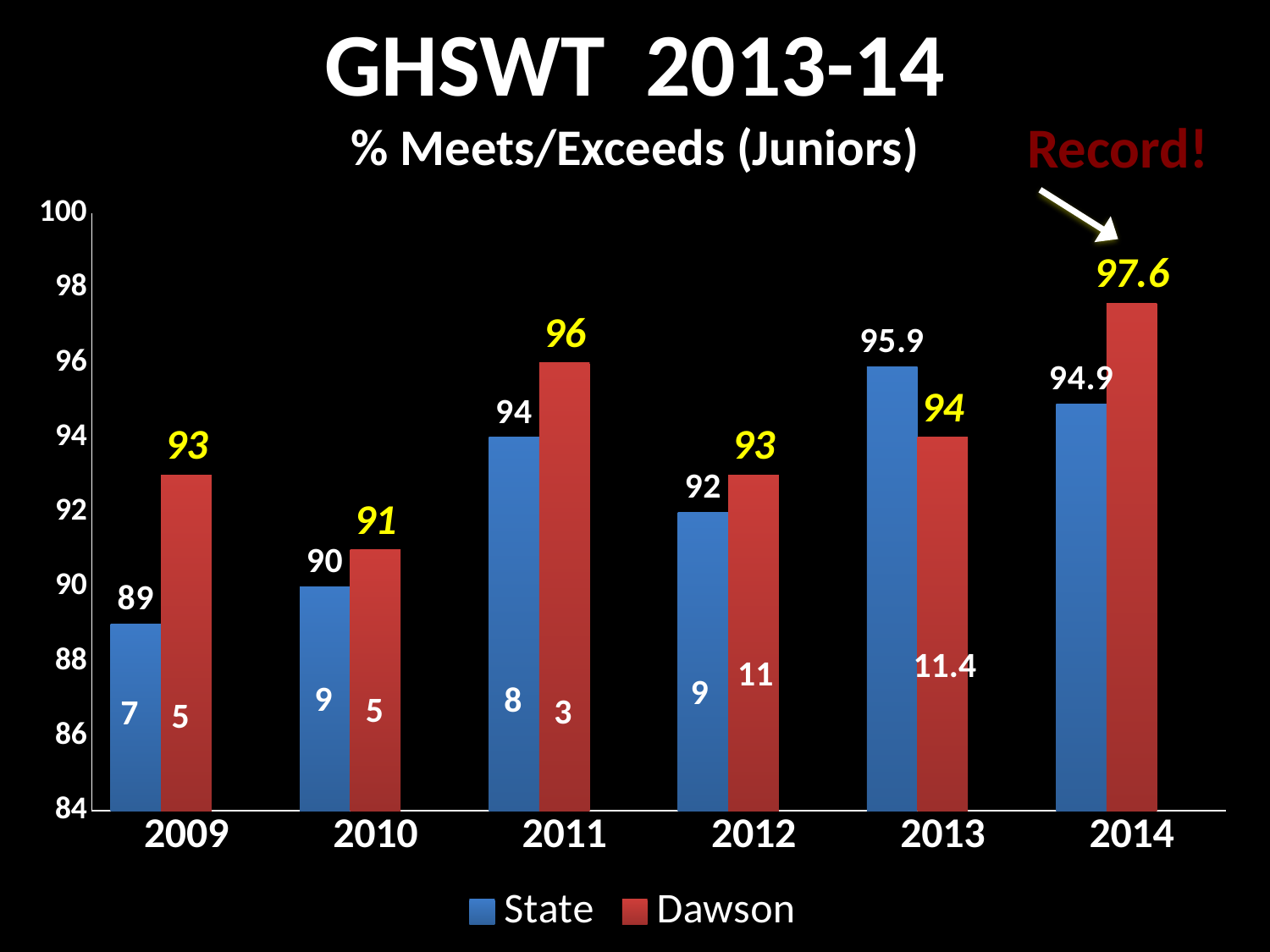
What is the Dawson value for 2011? 96 How many years are shown on the x axis? 6 What is the difference between the Dawson and State values in 2009? 4 What is the subtitle shown below the main chart title? % Meets/Exceeds (Juniors) What is the Dawson value for 2014? 97.6 In which year is the State value lowest? 2009 How many series does the legend list? 2 What is the State value for 2013? 95.9 Which is larger in 2013, the State value or the Dawson value? State What is the State value for 2009? 89 What kind of chart is shown on the slide? Bar chart In which year is the Dawson value highest? 2014